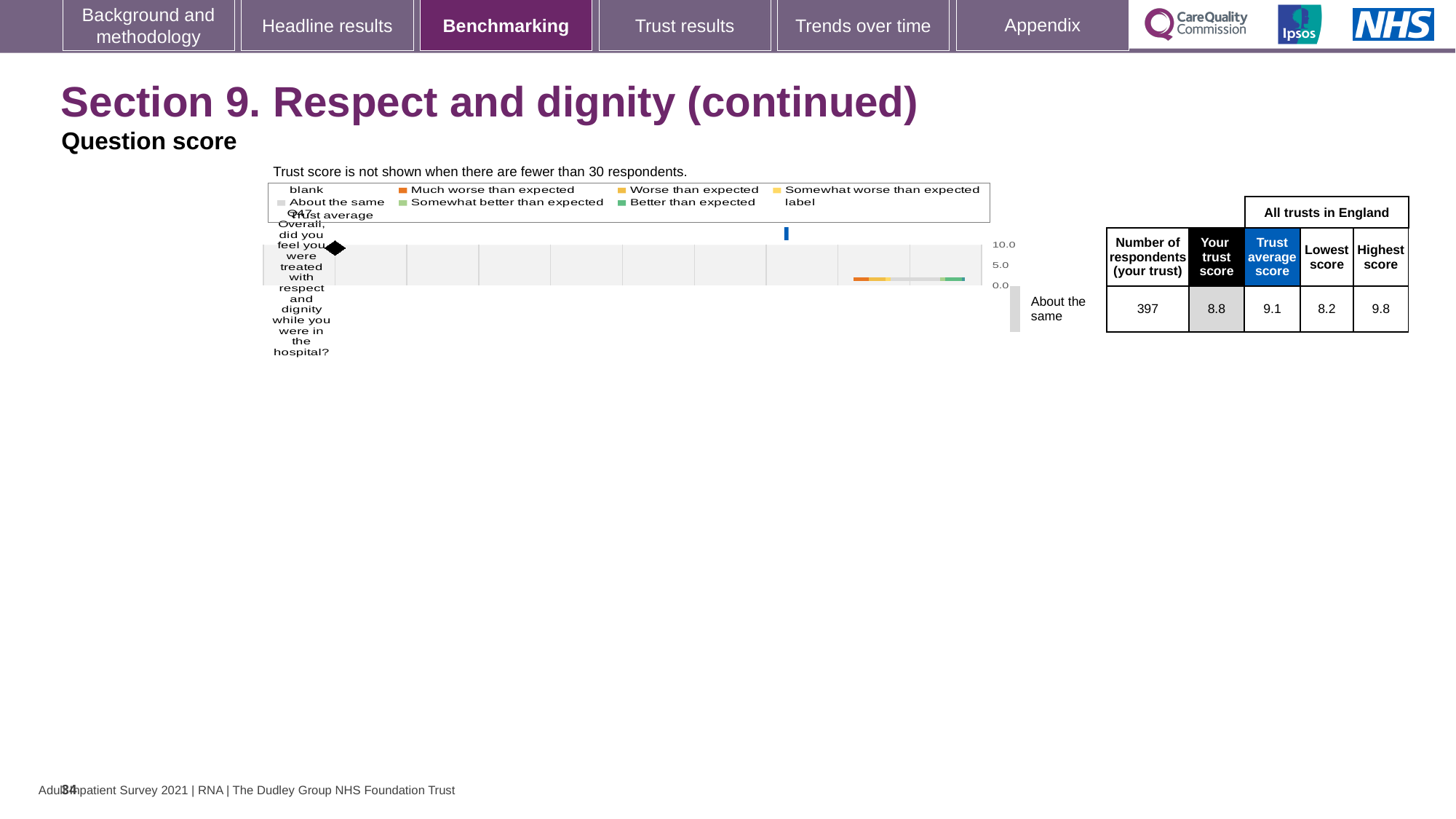
What kind of chart is shown on the slide? bar chart How many questions (categories) are plotted on the chart? 1 What is the highest value shown on the chart's numeric axis? 10.0 What is the highest score among all trusts in England for Q47? 9.8 How many respondents from the trust answered Q47? 397 What is the trust's score for Q47 (Overall, did you feel you were treated with respect and dignity while you were in the hospital?)? 8.8 What is the trust average score for Q47 across all trusts in England? 9.1 Is the trust's score for Q47 greater or less than 5.0? greater Which is larger for Q47: the trust's own score or the trust average score? Trust average score What is the difference between the highest and lowest scores among all trusts in England for Q47? 1.6 Which benchmark category is the trust's Q47 score placed in? About the same What is the lowest score among all trusts in England for Q47? 8.2